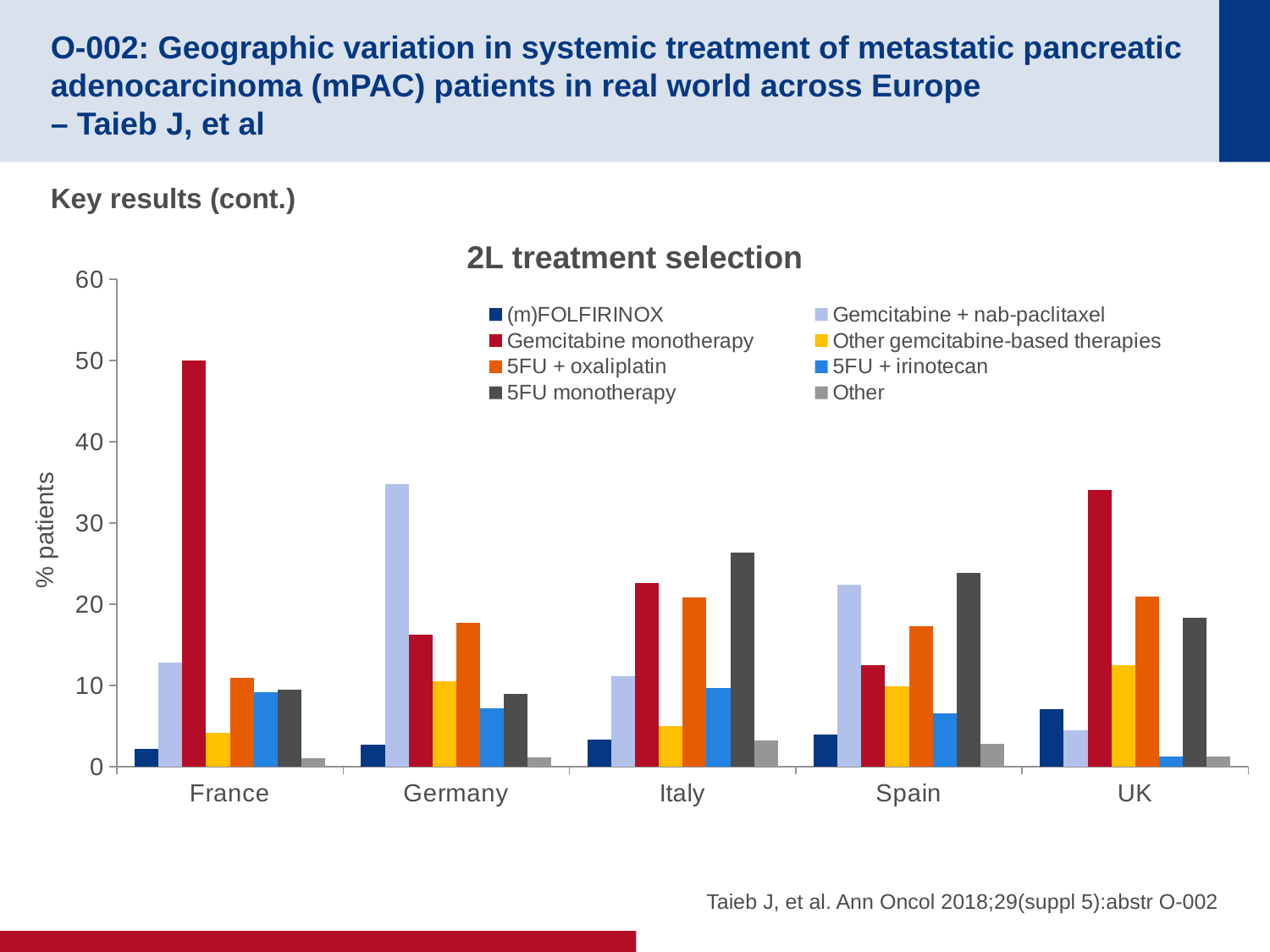
Is the value for 5FU monotherapy in Italy greater or less than 20? greater What kind of chart is shown on the slide? bar chart Is the value for Gemcitabine + nab-paclitaxel in Germany greater or less than 30? greater How many series does the legend list? 8 What is the value for Gemcitabine monotherapy in France? 50 In the UK, which is larger: Gemcitabine monotherapy or 5FU + oxaliplatin? Gemcitabine monotherapy In Spain, which is larger: 5FU monotherapy or Gemcitabine monotherapy? 5FU monotherapy Is the value for (m)FOLFIRINOX in France greater or less than 10? less What is the title of the chart? 2L treatment selection Which country has the lowest value for Gemcitabine + nab-paclitaxel? UK How many countries are shown on the x axis? 5 Which country has the highest value for Gemcitabine monotherapy? France